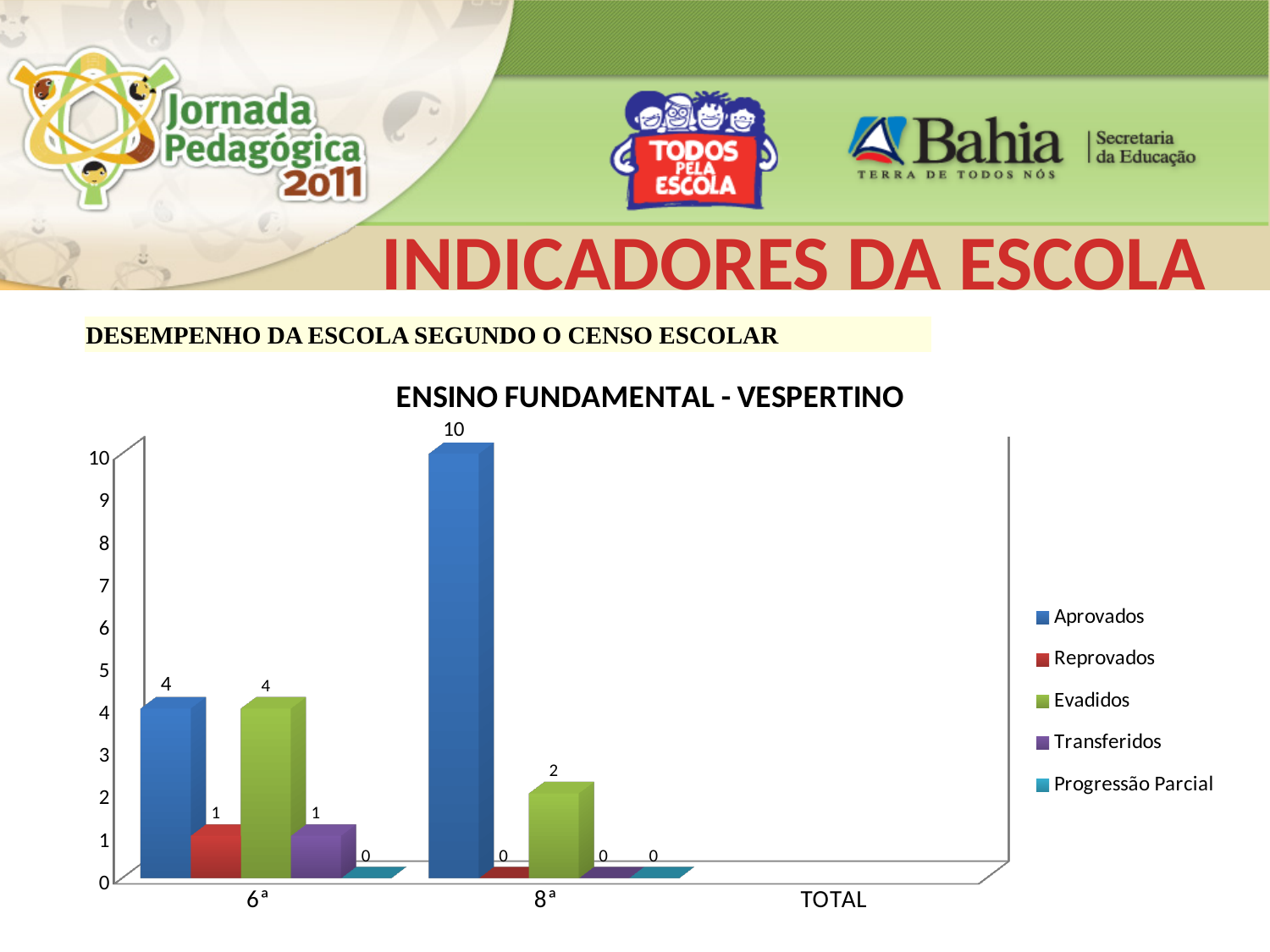
What is the difference between Aprovados for 8ª and Aprovados for 6ª? 6 Which series is shown in red in the legend? Reprovados How many series does the legend list? 5 What is the value of Aprovados for 8ª? 10 What is the value of Transferidos for 8ª? 0 What is the value of Evadidos for 8ª? 2 What kind of chart is shown on the slide? bar chart What is the value of Evadidos for 6ª? 4 Which is larger, Evadidos for 6ª or Evadidos for 8ª? Evadidos for 6ª What is the value of Reprovados for 6ª? 1 Which series has the highest value for 8ª? Aprovados What is the title of the chart? ENSINO FUNDAMENTAL - VESPERTINO